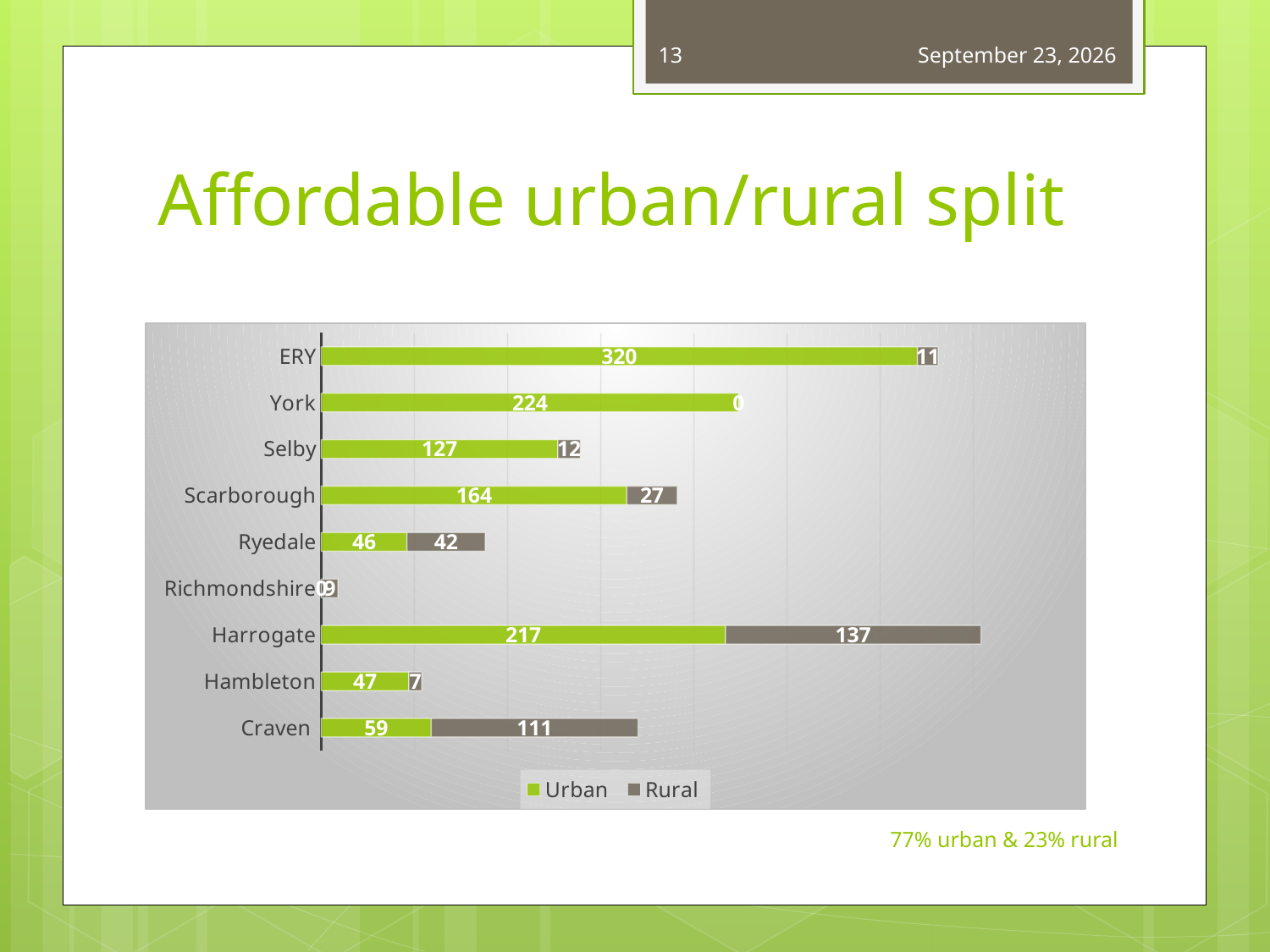
What is the Rural value for Craven? 111 What is the total of the stacked bar for Scarborough? 191 Which category has the highest Urban value? ERY What is the Urban value for Scarborough? 164 What is the Urban value for ERY? 320 Which category has the highest Rural value? Harrogate How many categories are shown on the chart? 9 What is the difference between the Urban and Rural values for Harrogate? 80 How many series does the legend list? 2 What is the Rural value for Harrogate? 137 Which is larger for Craven, the Urban value or the Rural value? Rural What kind of chart is shown on the slide? Stacked bar chart